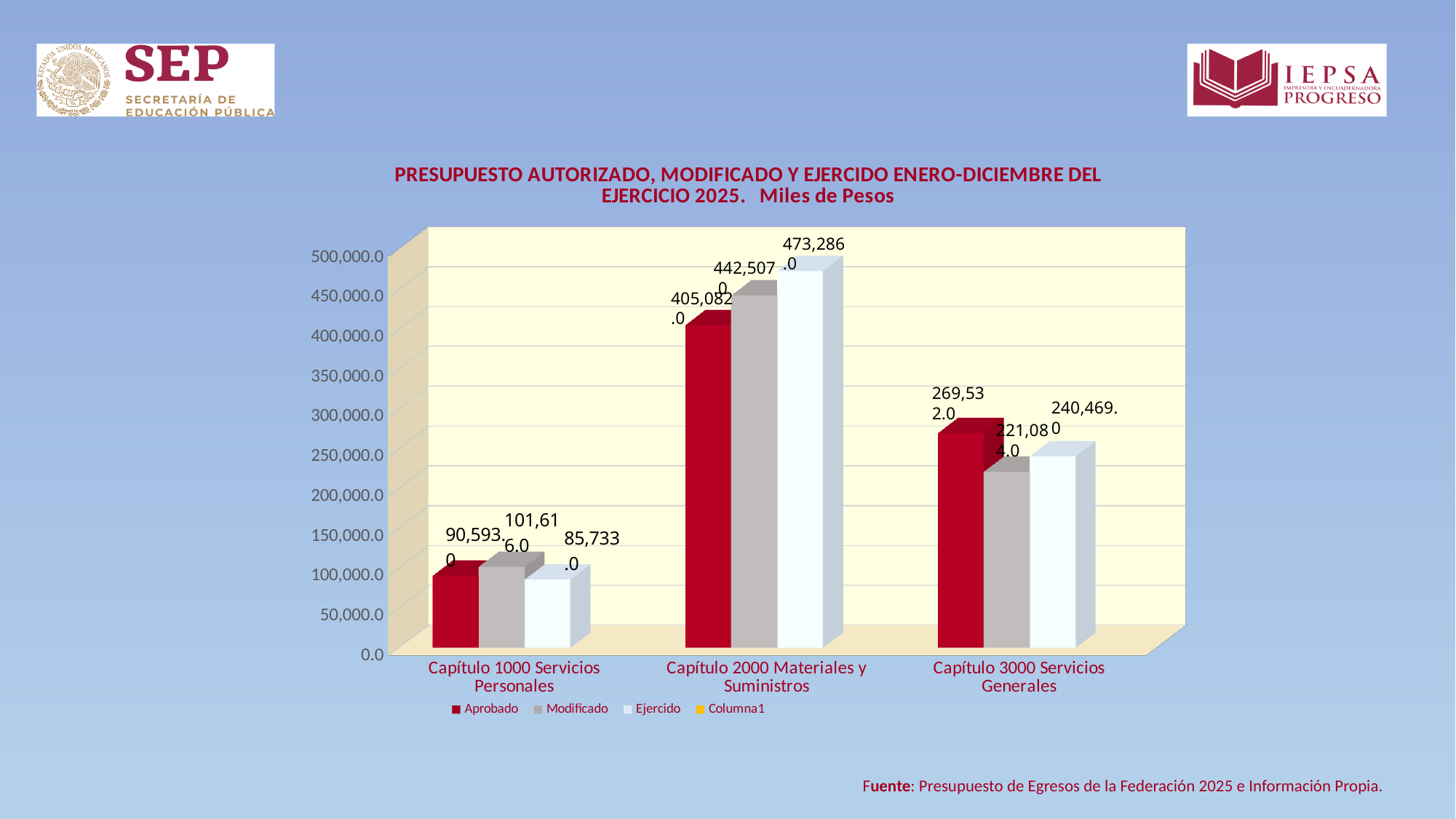
What is the Aprobado value for Capítulo 1000 Servicios Personales? 90,593.0 Is the Modificado value for Capítulo 1000 Servicios Personales greater or less than 100,000.0? greater How many series does the legend list? 4 Which category has the lowest Ejercido value? Capítulo 1000 Servicios Personales For Capítulo 3000 Servicios Generales, which is larger: the Aprobado value or the Ejercido value? Aprobado What is the Modificado value for Capítulo 3000 Servicios Generales? 221,084.0 What kind of chart is shown on the slide? Bar chart How many categories are shown on the x axis? 3 What is the Ejercido value for Capítulo 2000 Materiales y Suministros? 473,286.0 Which category has the highest Aprobado value? Capítulo 2000 Materiales y Suministros What is the difference between the Ejercido and Aprobado values for Capítulo 2000 Materiales y Suministros? 68,204.0 What unit is stated in the chart title? Miles de Pesos